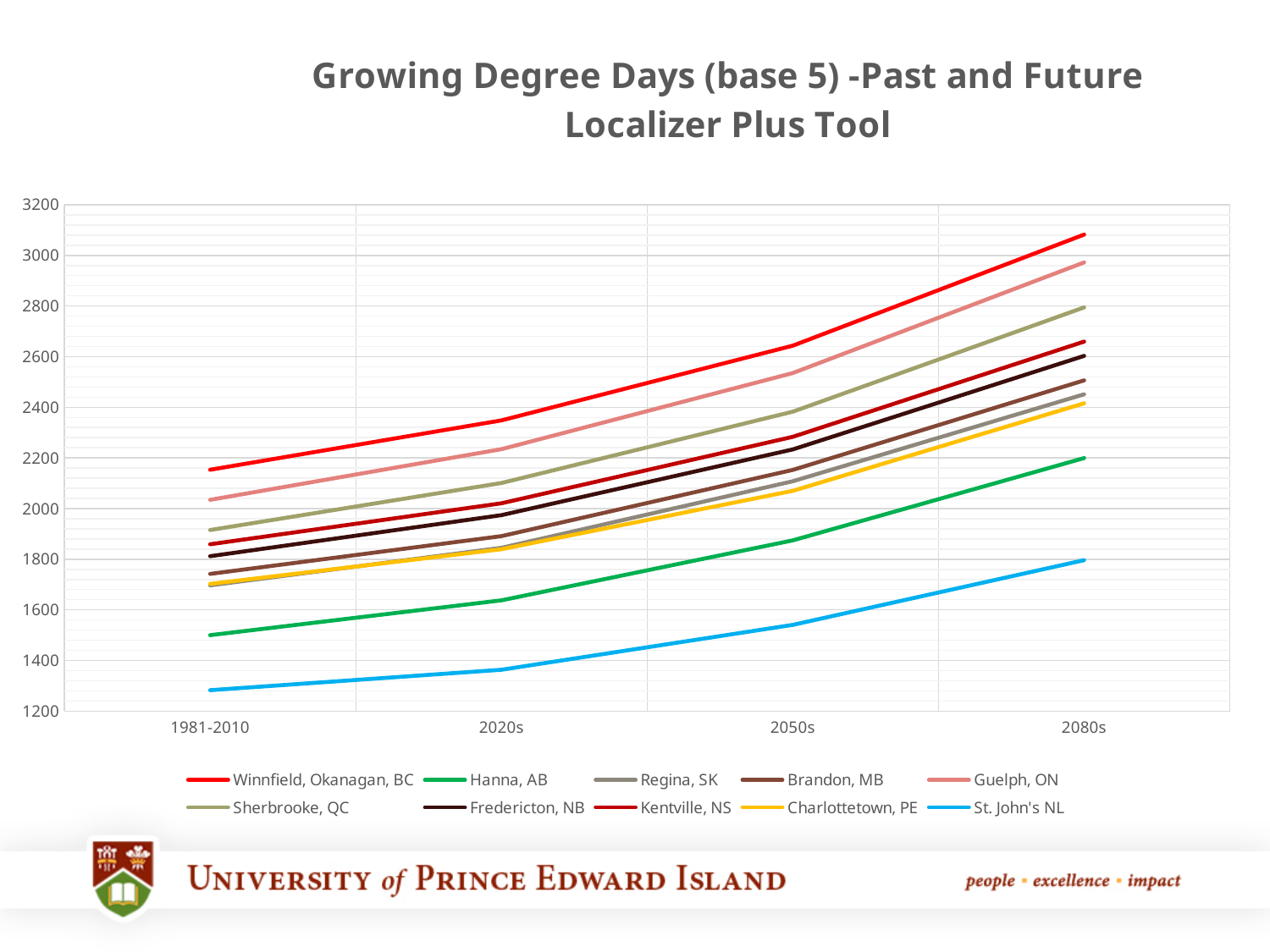
Is the value for St. John's NL in the 2080s greater or less than 2000? less What kind of chart is shown on the slide? line chart Which location has the highest growing degree days in the 2080s? Winnfield, Okanagan, BC Is the value for Hanna, AB in 1981-2010 greater or less than 1600? less How many series does the legend list? 10 What is the title of the chart? Growing Degree Days (base 5) -Past and Future Localizer Plus Tool Is the value for Guelph, ON in the 2050s greater or less than 2400? greater Which location has the lowest growing degree days in the 2080s? St. John's NL Do the growing degree days for Hanna, AB rise or fall from 1981-2010 to the 2080s? rise In the 2050s, which is larger: the value for Hanna, AB or the value for St. John's NL? Hanna, AB How many time periods are shown along the x axis? 4